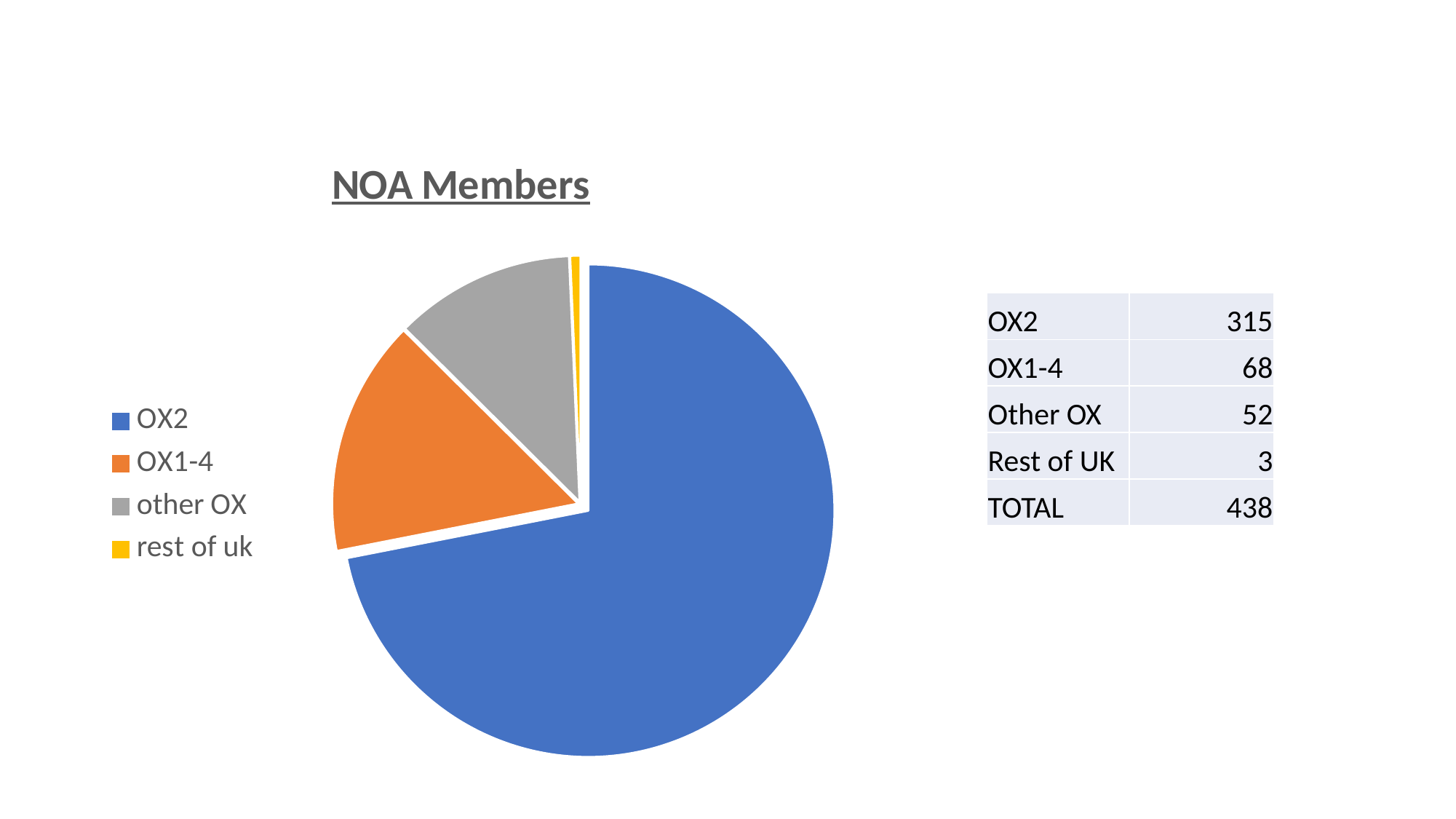
What is the difference between the values for OX2 and OX1-4? 247 What is the value for Other OX? 52 What is the value for OX1-4? 68 What is the value for OX2? 315 What is the title of the chart? NOA Members Which is larger, the value for OX1-4 or the value for Other OX? OX1-4 Which category has the smallest slice of the pie? rest of uk What is the value for Rest of UK? 3 Which category has the largest slice of the pie? OX2 What is the total number of NOA members shown in the table? 438 What type of chart is shown on the slide? pie chart How many categories does the pie chart have? 4